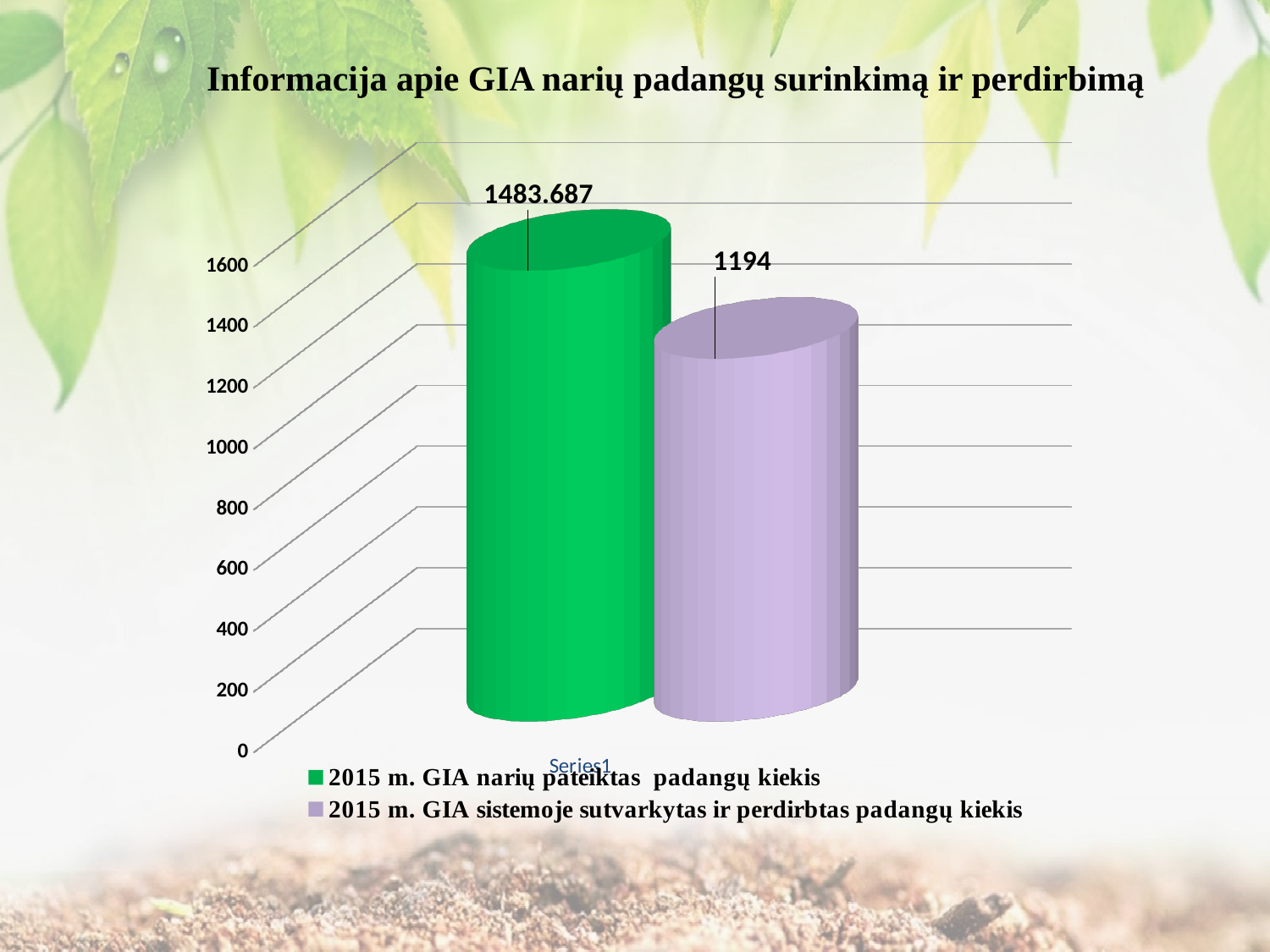
Is the value for '2015 m. GIA narių pateiktas padangų kiekis' greater or less than 1400? greater What value is shown for '2015 m. GIA narių pateiktas padangų kiekis'? 1483.687 Which series has the lower value? 2015 m. GIA sistemoje sutvarkytas ir perdirbtas padangų kiekis Is the value for '2015 m. GIA narių pateiktas padangų kiekis' larger or smaller than the value for '2015 m. GIA sistemoje sutvarkytas ir perdirbtas padangų kiekis'? larger Which series has the higher value? 2015 m. GIA narių pateiktas padangų kiekis Is the value for '2015 m. GIA sistemoje sutvarkytas ir perdirbtas padangų kiekis' greater or less than 1200? less What kind of chart is shown on the slide? bar chart What value is shown for '2015 m. GIA sistemoje sutvarkytas ir perdirbtas padangų kiekis'? 1194 How many series does the legend list? 2 What is the title of the slide? Informacija apie GIA narių padangų surinkimą ir perdirbimą What is the difference between the value for '2015 m. GIA narių pateiktas padangų kiekis' and the value for '2015 m. GIA sistemoje sutvarkytas ir perdirbtas padangų kiekis'? 289.687 What colour is the bar for '2015 m. GIA narių pateiktas padangų kiekis'? green